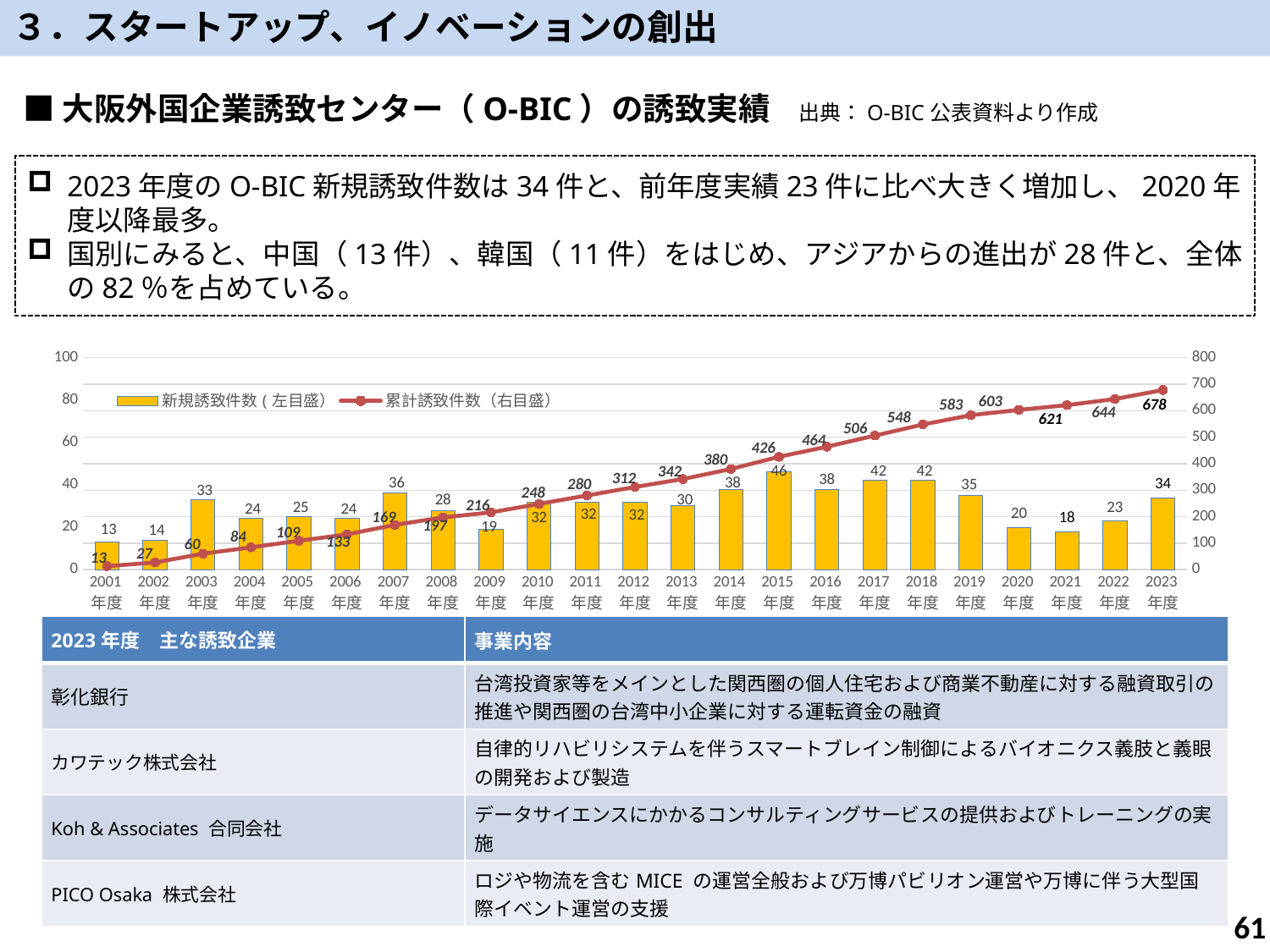
Which fiscal year has the highest 新規誘致件数? 2015年度 Which is larger, the 新規誘致件数 for 2017年度 or for 2019年度? 2017年度 What is the value of 累計誘致件数 for 2023年度? 678 Does the 累計誘致件数 line rise or fall from 2001年度 to 2023年度? Rises What is the value of 新規誘致件数 for 2015年度? 46 What is the difference in 累計誘致件数 between 2022年度 and 2021年度? 23 How many fiscal years are shown on the x axis of the chart? 23 What kind of chart is used for 新規誘致件数? Bar chart What is the difference in 新規誘致件数 between 2023年度 and 2022年度? 11 Which fiscal year has the lowest 新規誘致件数? 2001年度 How many series does the chart legend list? 2 What is the value of 新規誘致件数 for 2023年度? 34